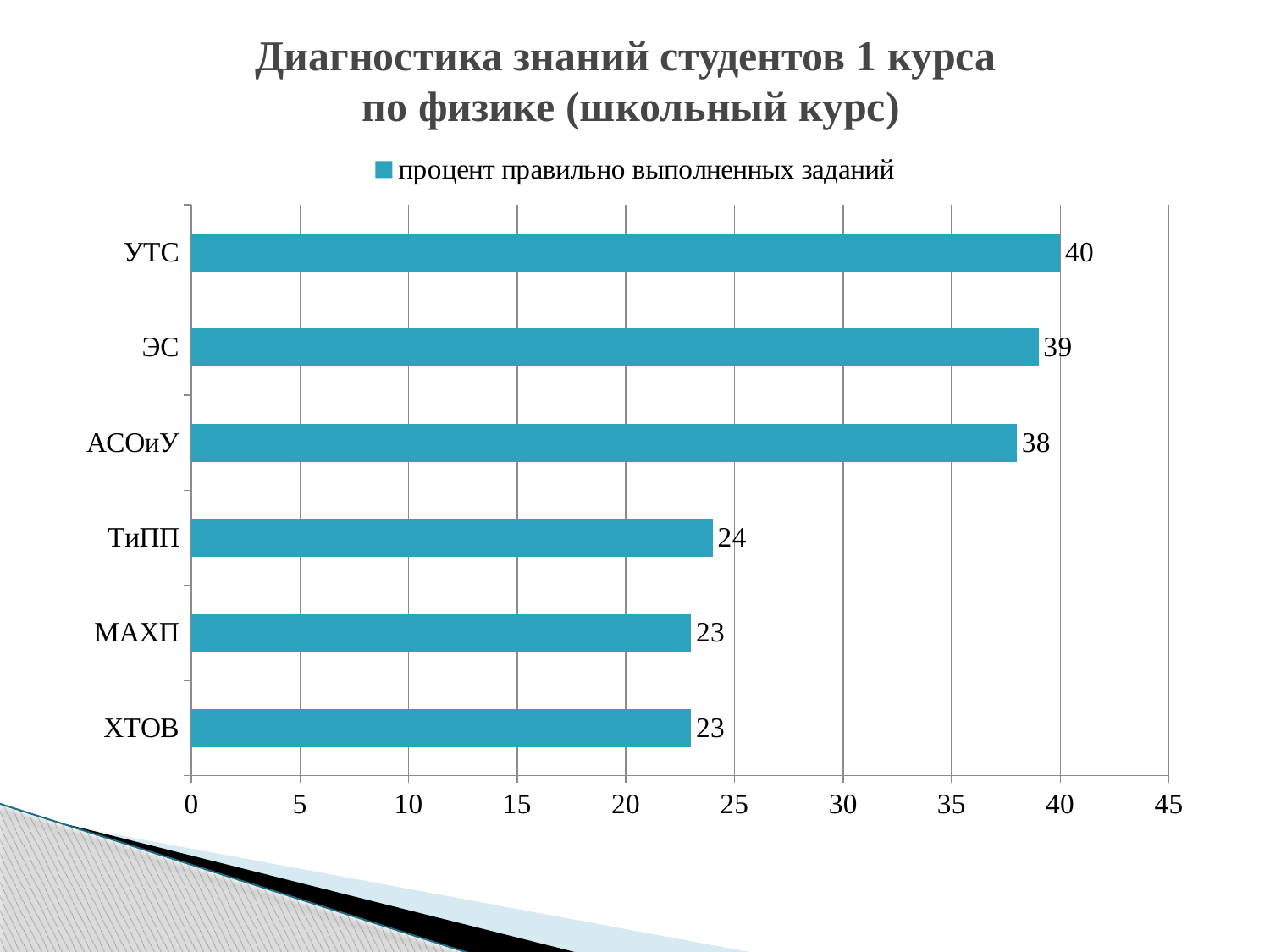
How many categories are shown in the chart? 6 What is the value for АСОиУ? 38 Is the value for ЭС greater or less than 30? greater How many series does the legend list? 1 Which is larger, the value for АСОиУ or the value for МАХП? АСОиУ What is the value for УТС? 40 What is the difference between the values for ЭС and ТиПП? 15 What kind of chart is shown on the slide? bar chart What is the legend entry of the chart? процент правильно выполненных заданий What is the value for ТиПП? 24 Which category has the highest value? УТС What is the difference between the values for УТС and ХТОВ? 17